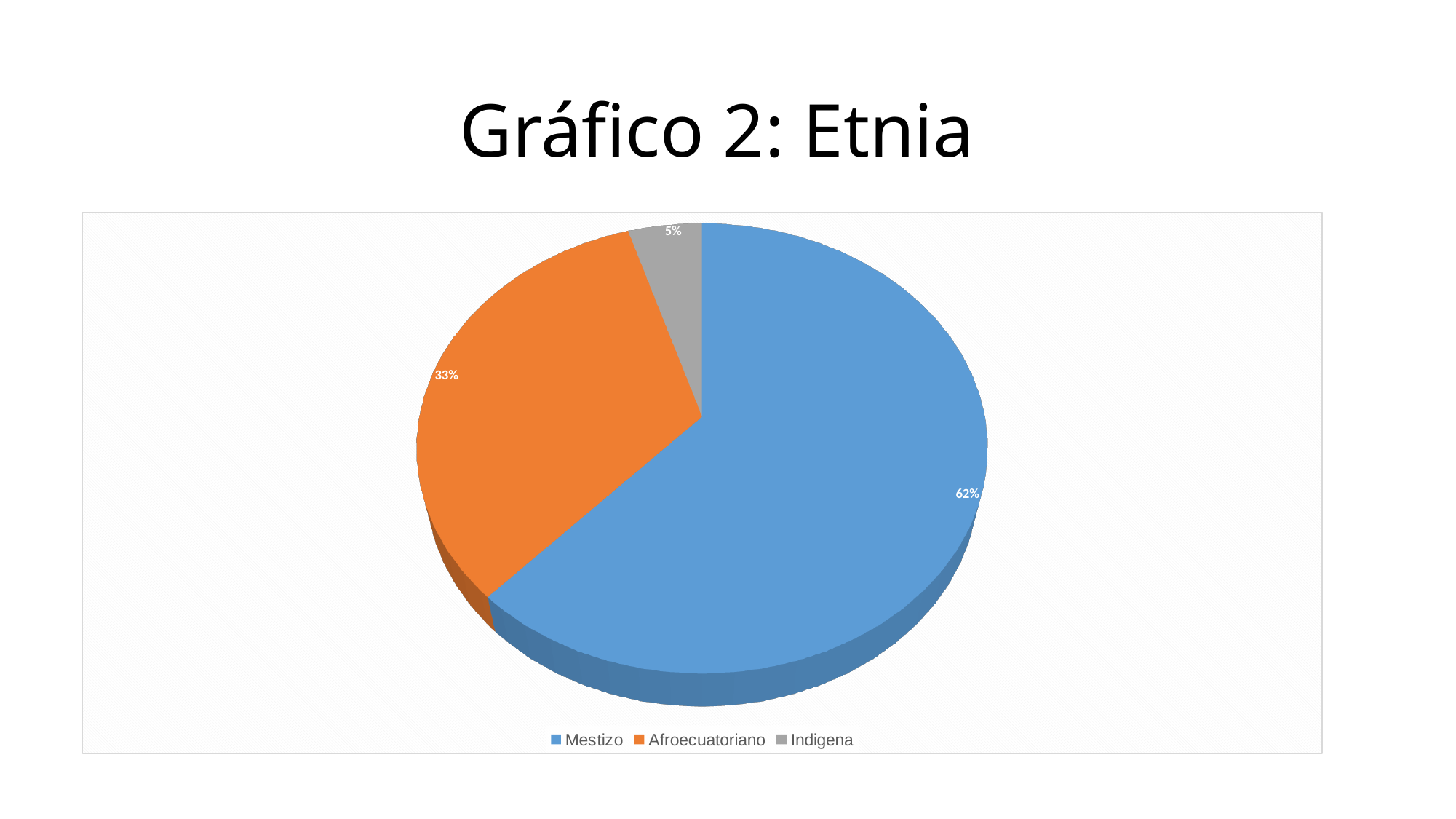
What percentage of the pie is Mestizo? 62% How many categories does the pie chart have? 3 Which category has the largest share of the pie? Mestizo What kind of chart is shown on the slide? pie chart Which category has the smallest share of the pie? Indigena What is the difference in percentage points between Mestizo and Afroecuatoriano? 29 What percentage of the pie is Indigena? 5% Which is larger, the share for Afroecuatoriano or the share for Indigena? Afroecuatoriano What is the title of the slide? Gráfico 2: Etnia What colour is the Afroecuatoriano slice? orange What is the difference in percentage points between Afroecuatoriano and Indigena? 28 What percentage of the pie is Afroecuatoriano? 33%